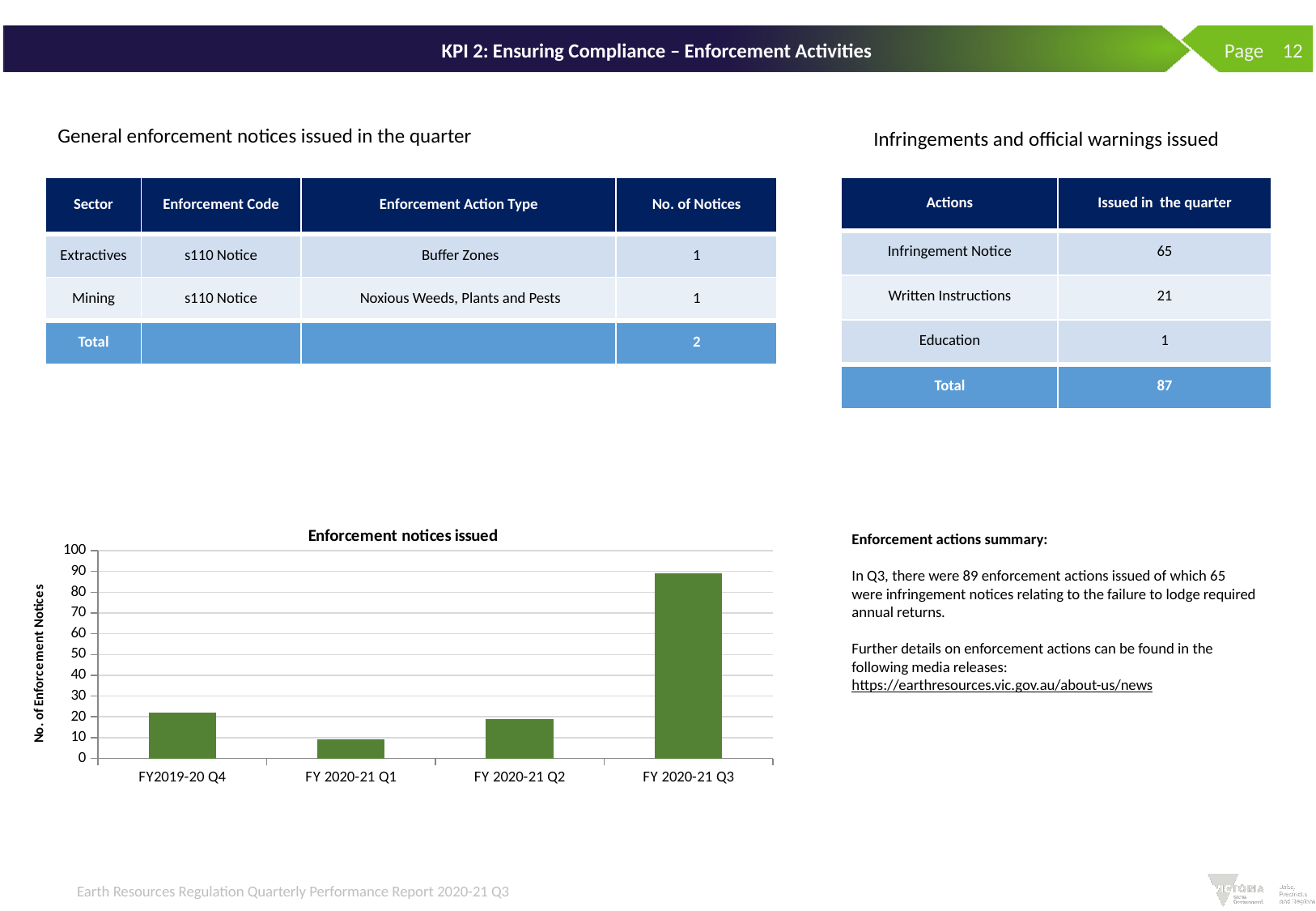
Which quarter has the lowest number of enforcement notices in the 'Enforcement notices issued' chart? FY 2020-21 Q1 In the 'Enforcement notices issued' chart, is the value for FY 2020-21 Q3 greater or less than 80? greater What is the y-axis label of the 'Enforcement notices issued' chart? No. of Enforcement Notices In the 'Enforcement notices issued' chart, which is larger: the value for FY 2020-21 Q2 or FY 2020-21 Q1? FY 2020-21 Q2 How many quarters are shown on the x axis of the 'Enforcement notices issued' chart? 4 What kind of chart is 'Enforcement notices issued'? bar chart In the 'Enforcement notices issued' chart, which is larger: the value for FY 2020-21 Q3 or FY 2020-21 Q1? FY 2020-21 Q3 Which quarter has the highest number of enforcement notices in the 'Enforcement notices issued' chart? FY 2020-21 Q3 What is the highest value shown on the y axis of the 'Enforcement notices issued' chart? 100